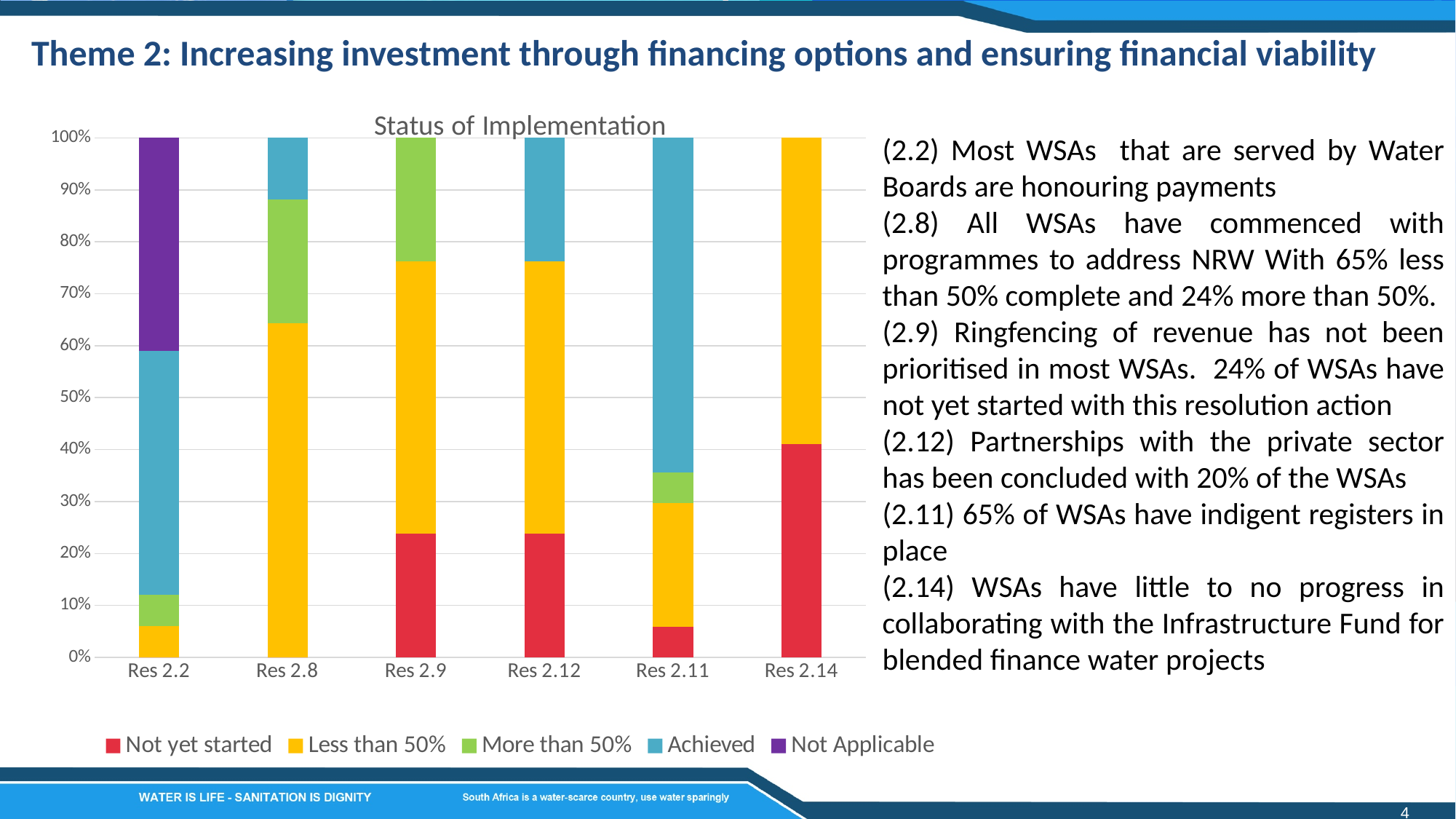
How many series does the chart legend list? 5 What kind of chart is shown on the slide? Stacked bar chart Which has a larger 'Achieved' share, Res 2.2 or Res 2.11? Res 2.11 Is the 'Not yet started' share for Res 2.9 greater or less than 30%? less Which resolution has the largest 'Not yet started' share? Res 2.14 How many resolution categories are shown on the x axis of the chart? 6 What is the title of the chart? Status of Implementation What is the total height of the Res 2.8 bar? 100% Is the 'Achieved' share for Res 2.11 greater or less than 60%? greater Is the 'Not yet started' share for Res 2.14 greater or less than 30%? greater Which resolution has the largest 'Achieved' share? Res 2.11